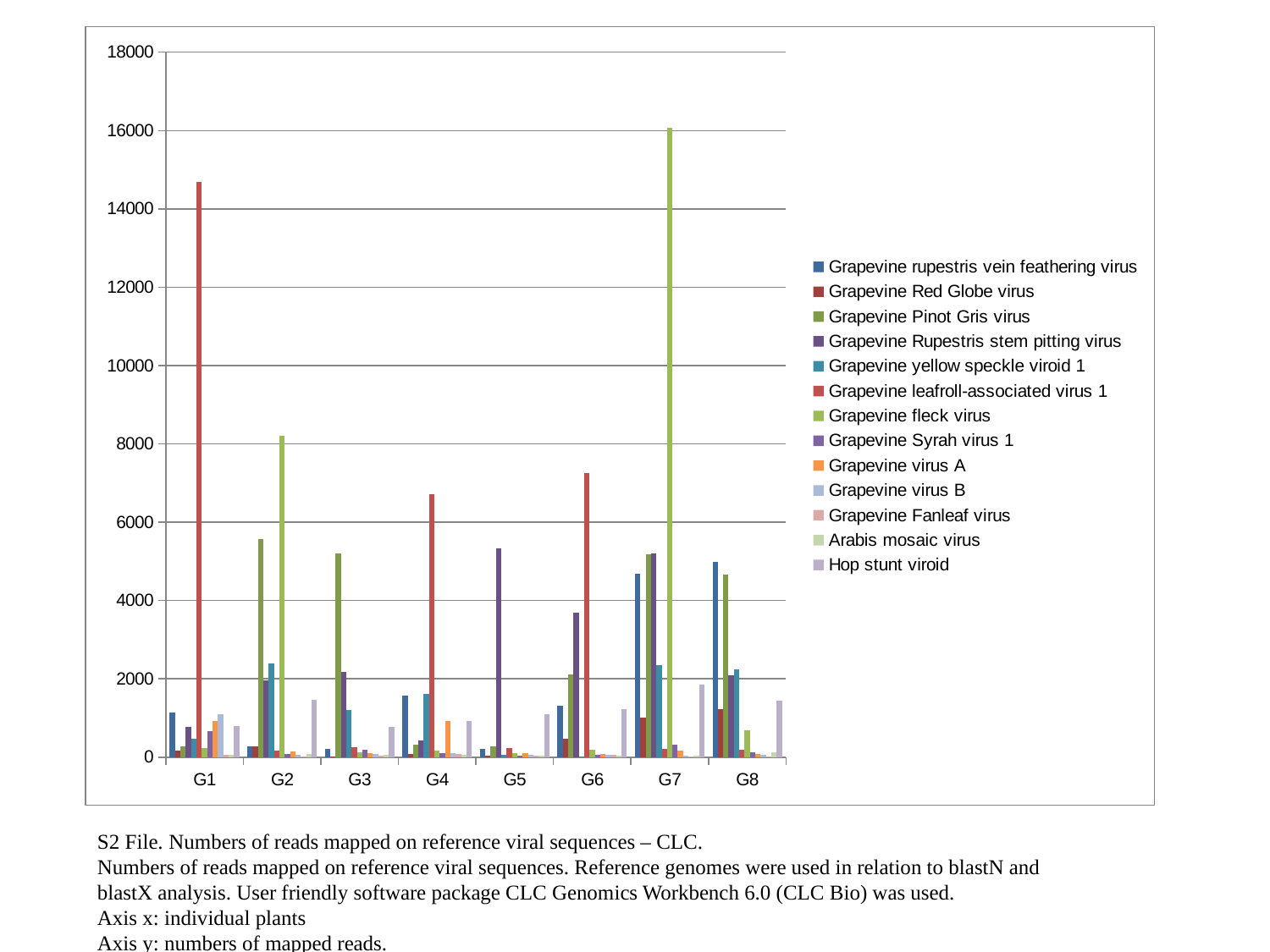
Which is larger: Grapevine leafroll-associated virus 1 at G1 or Grapevine fleck virus at G7? Grapevine fleck virus at G7 Which plant has the single tallest bar in the chart? G7 How many series does the legend list? 13 What kind of chart is shown on the slide? bar chart What is the highest value shown on the y axis? 18000 Is the value for Grapevine leafroll-associated virus 1 at G1 greater or less than 14000? greater Is the value for Grapevine fleck virus at G2 greater or less than 6000? greater Is the value for Grapevine leafroll-associated virus 1 at G4 greater or less than 8000? less How many individual plants (categories) are shown on the x axis? 8 Which series has the highest value at G1? Grapevine leafroll-associated virus 1